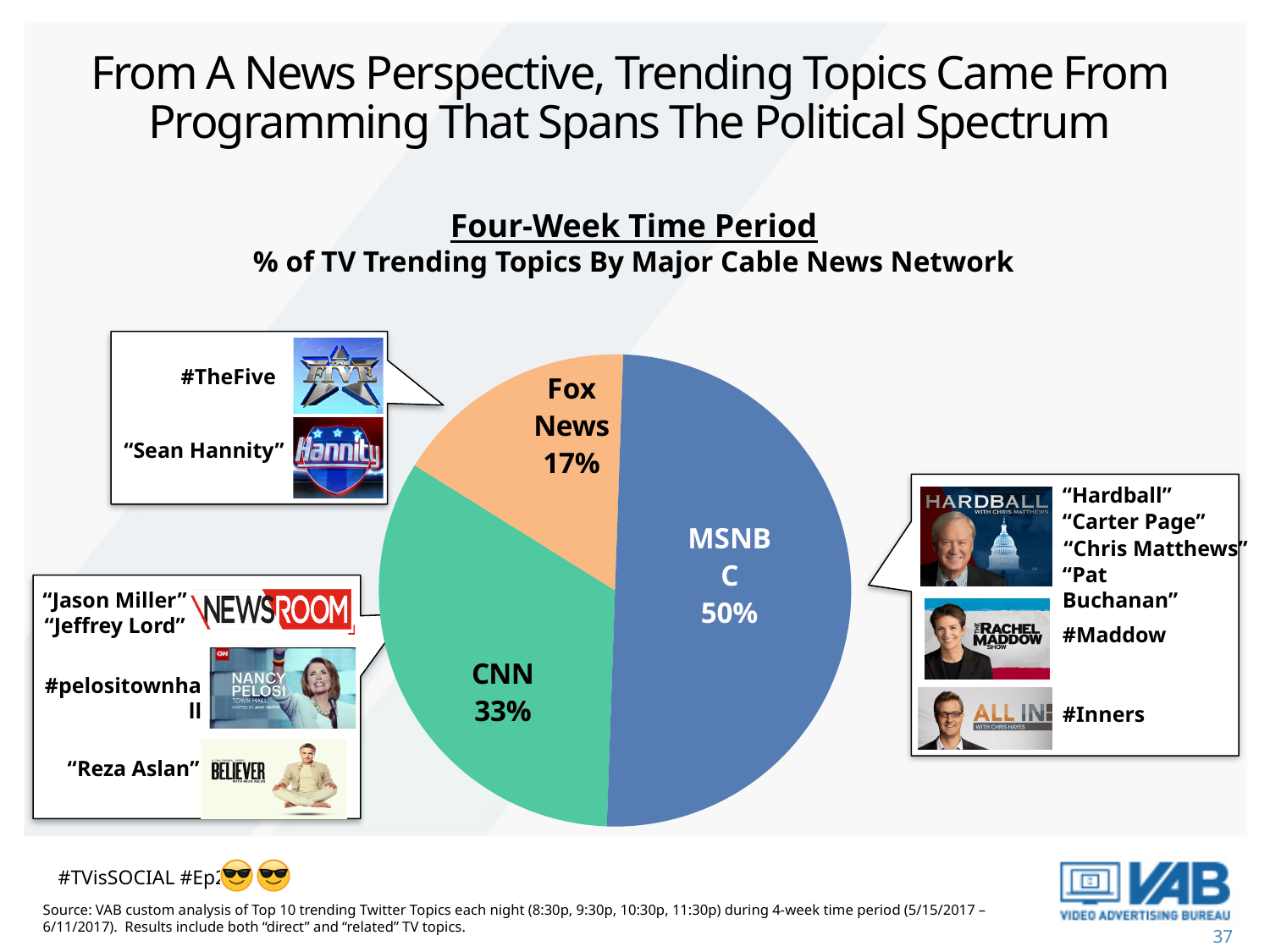
How many percentage points higher is MSNBC's share than CNN's share? 17 What share of TV trending topics does Fox News account for in the pie chart? 17% How many percentage points higher is CNN's share than Fox News's share? 16 What is the combined share of CNN and Fox News in the pie chart? 50% Which cable news network has the largest share of TV trending topics? MSNBC What share of TV trending topics does CNN account for in the pie chart? 33% What kind of chart is used to show the % of TV trending topics by major cable news network? Pie chart What share of TV trending topics does MSNBC account for in the pie chart? 50% Which cable news network has the smallest share of TV trending topics? Fox News What time period does the chart title say the data covers? Four-Week Time Period Which has a larger share of TV trending topics, CNN or Fox News? CNN How many cable news networks are shown in the pie chart? 3